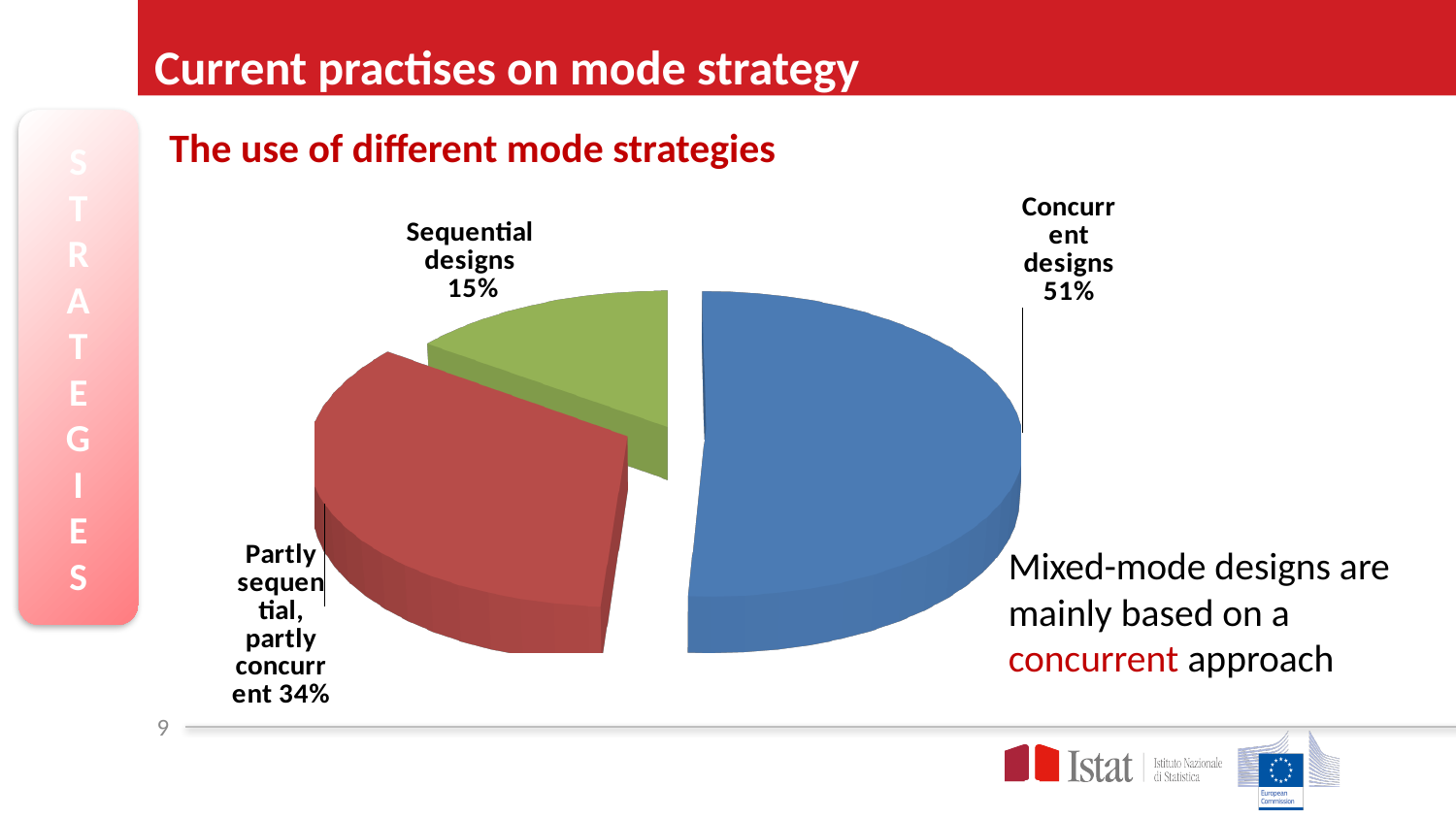
What share of the pie is Concurrent designs? 51% Which is larger: the share for Partly sequential, partly concurrent designs or the share for Sequential designs? Partly sequential, partly concurrent designs What share of the pie is Sequential designs? 15% What is the title shown above the pie chart? The use of different mode strategies What kind of chart is shown on the slide? Pie chart How many slices does the pie chart have? 3 What is the difference in percentage points between Partly sequential, partly concurrent designs and Sequential designs? 19 What is the difference in percentage points between Concurrent designs and Sequential designs? 36 Which slice of the pie is the largest? Concurrent designs Which slice of the pie is the smallest? Sequential designs What share of the pie is Partly sequential, partly concurrent designs? 34% What colour is the Concurrent designs slice? Blue